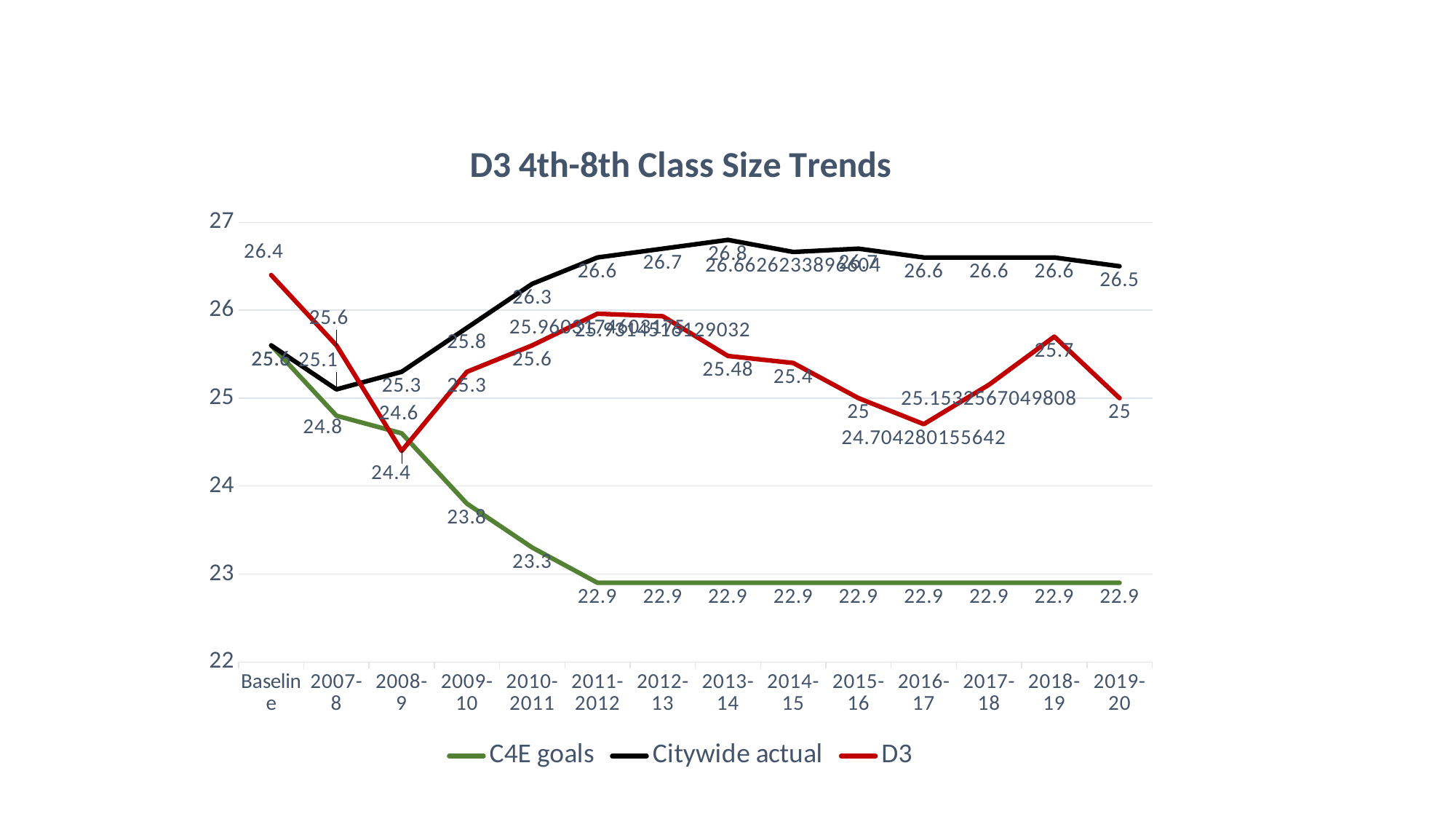
How many categories are on the x axis? 14 Which is larger for 2018-19, the D3 value or the Citywide actual value? Citywide actual What is the Citywide actual value for 2013-14? 26.8 In which year is the Citywide actual value highest? 2013-14 What is the C4E goals value for 2019-20? 22.9 What is the D3 value for 2008-9? 24.4 How many series does the legend list? 3 What is the D3 value for 2018-19? 25.7 What is the difference between the Citywide actual and D3 values for 2019-20? 1.5 What kind of chart is shown on the slide? line chart Do the C4E goals values rise or fall from Baseline to 2011-2012? fall In which year is the D3 value lowest? 2008-9